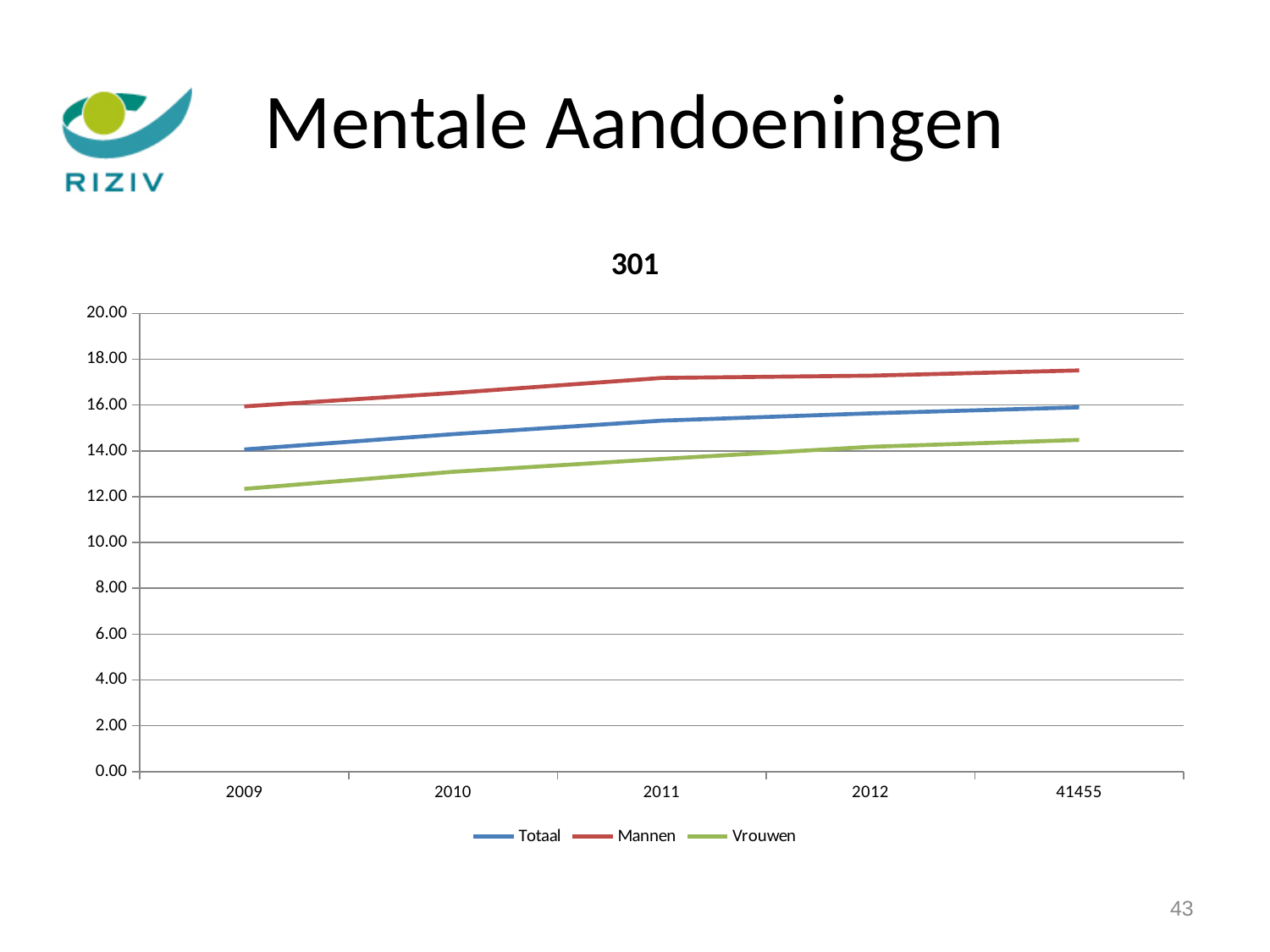
What kind of chart is shown on the slide? line chart Which series has the lowest value in 2009? Vrouwen What is the title of the chart? 301 Which series has the highest value in 2011? Mannen Does the Vrouwen line rise or fall across the x axis? rise Which series are listed in the legend? Totaal, Mannen, Vrouwen Is the value for Totaal in 2012 greater or less than 14.00? greater How many points along the x axis does each line have? 5 Does the Mannen line rise or fall from 2009 to the last point? rise Is the value for Mannen in 2011 greater or less than 16.00? greater How many series does the legend list? 3 In 2012, which is larger: the value for Totaal or the value for Vrouwen? Totaal